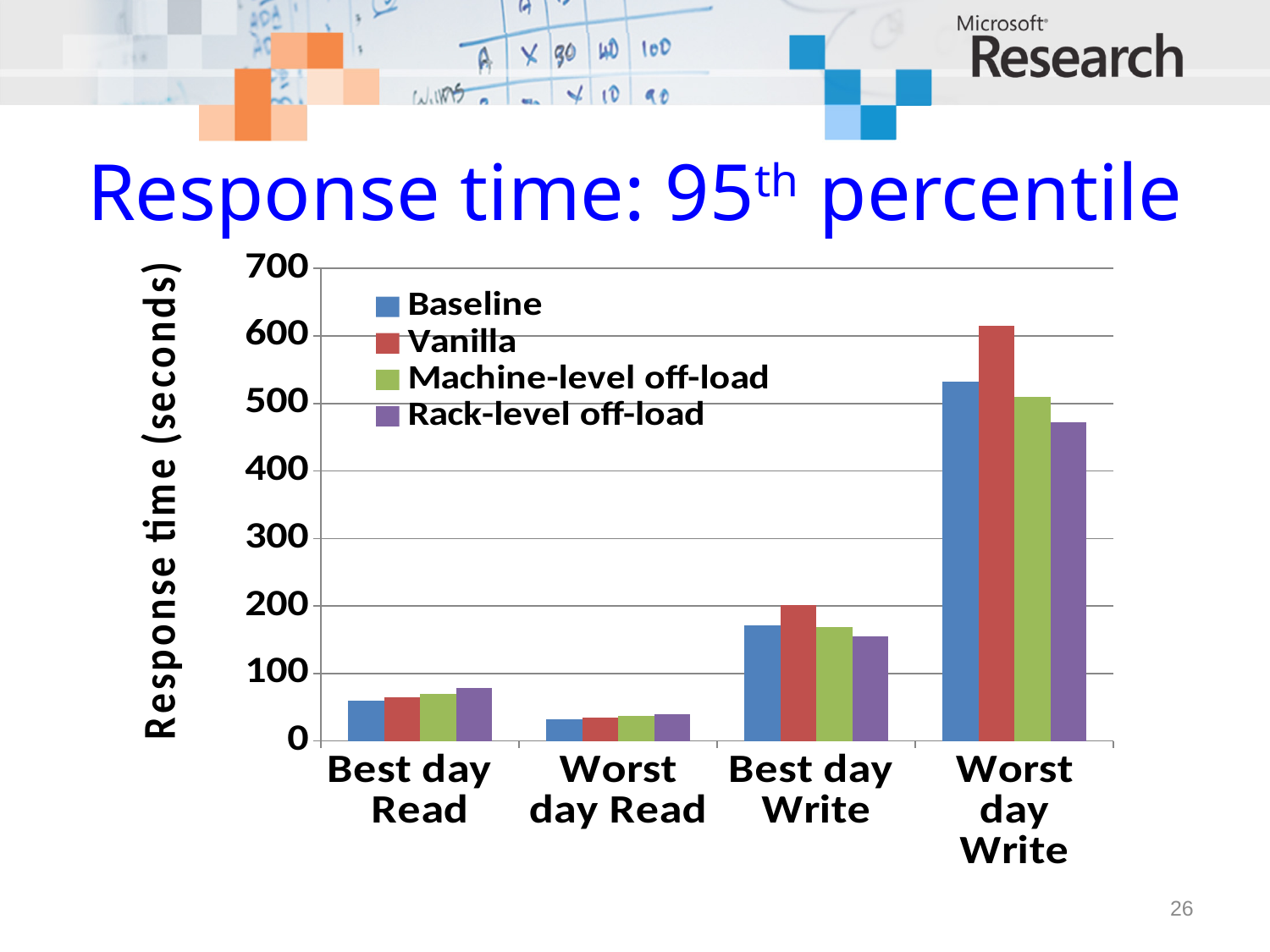
Is the Vanilla value for Worst day Write greater or less than 500? greater For Worst day Write, which is larger: the Vanilla value or the Rack-level off-load value? Vanilla Which category has the lowest Baseline response time? Worst day Read Is the Baseline value for Best day Write greater or less than 200? less What is the label on the chart's vertical axis? Response time (seconds) Is the Rack-level off-load value for Worst day Write greater or less than 400? greater Which category has the highest Vanilla response time? Worst day Write How many categories are shown on the x axis of the chart? 4 What kind of chart is shown on the slide? bar chart Within the Worst day Write category, which series has the tallest bar? Vanilla How many series does the chart's legend list? 4 For Best day Write, which is larger: the Vanilla value or the Baseline value? Vanilla